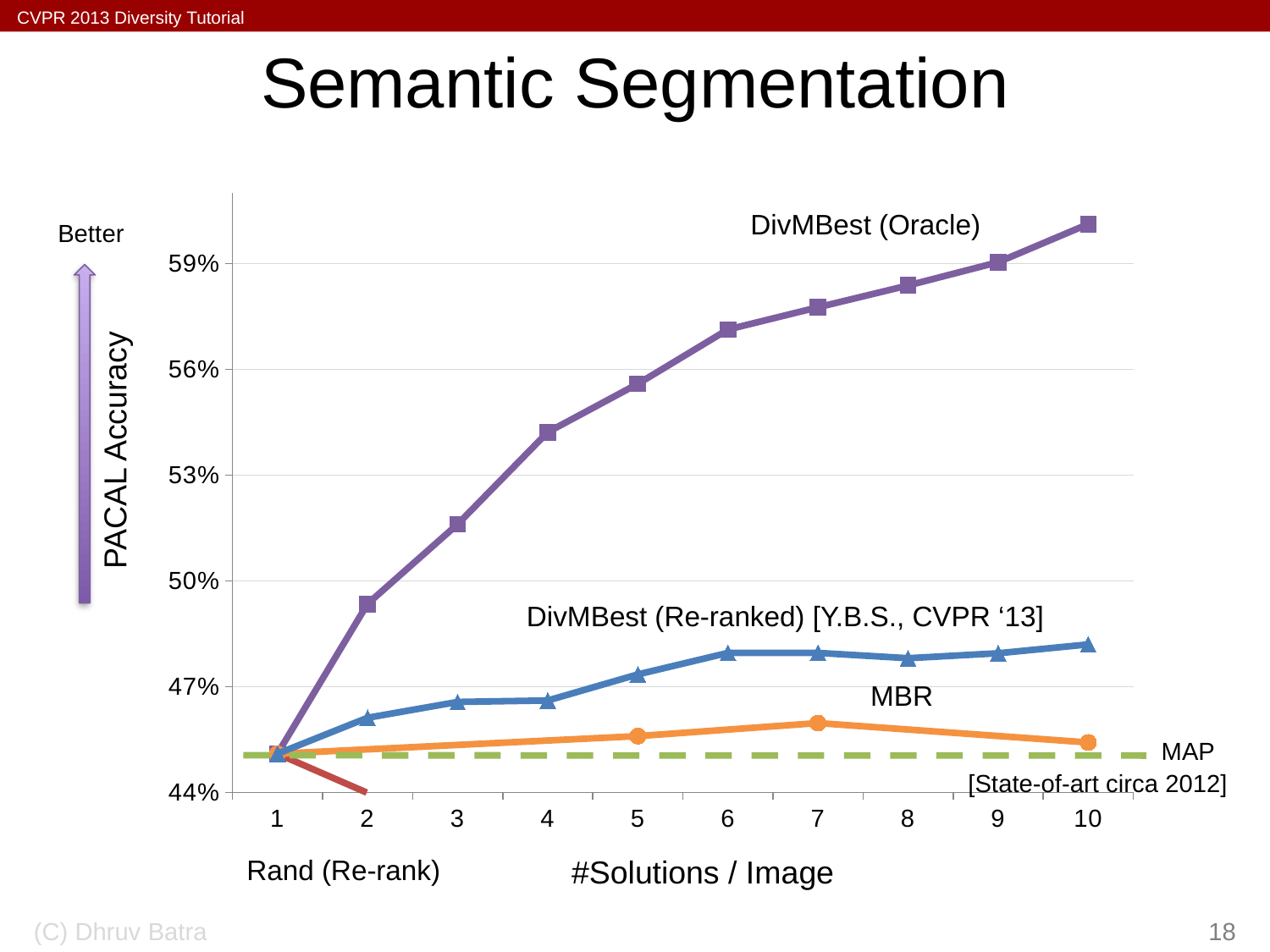
Is the DivMBest (Re-ranked) value at 10 solutions per image greater or less than 47%? greater Which line is drawn as a dashed green horizontal line? MAP How many values of #Solutions / Image are shown on the x axis? 10 At 6 solutions per image, which is higher: DivMBest (Re-ranked) or MBR? DivMBest (Re-ranked) Which line has the highest PACAL Accuracy at 10 solutions per image? DivMBest (Oracle) What is the label of the y axis? PACAL Accuracy Is the DivMBest (Oracle) value at 2 solutions per image greater or less than 50%? less What kind of chart is shown on the slide? line chart Does the DivMBest (Oracle) line rise or fall as #Solutions / Image increases from 1 to 10? rises Is the DivMBest (Oracle) value at 10 solutions per image greater or less than 59%? greater